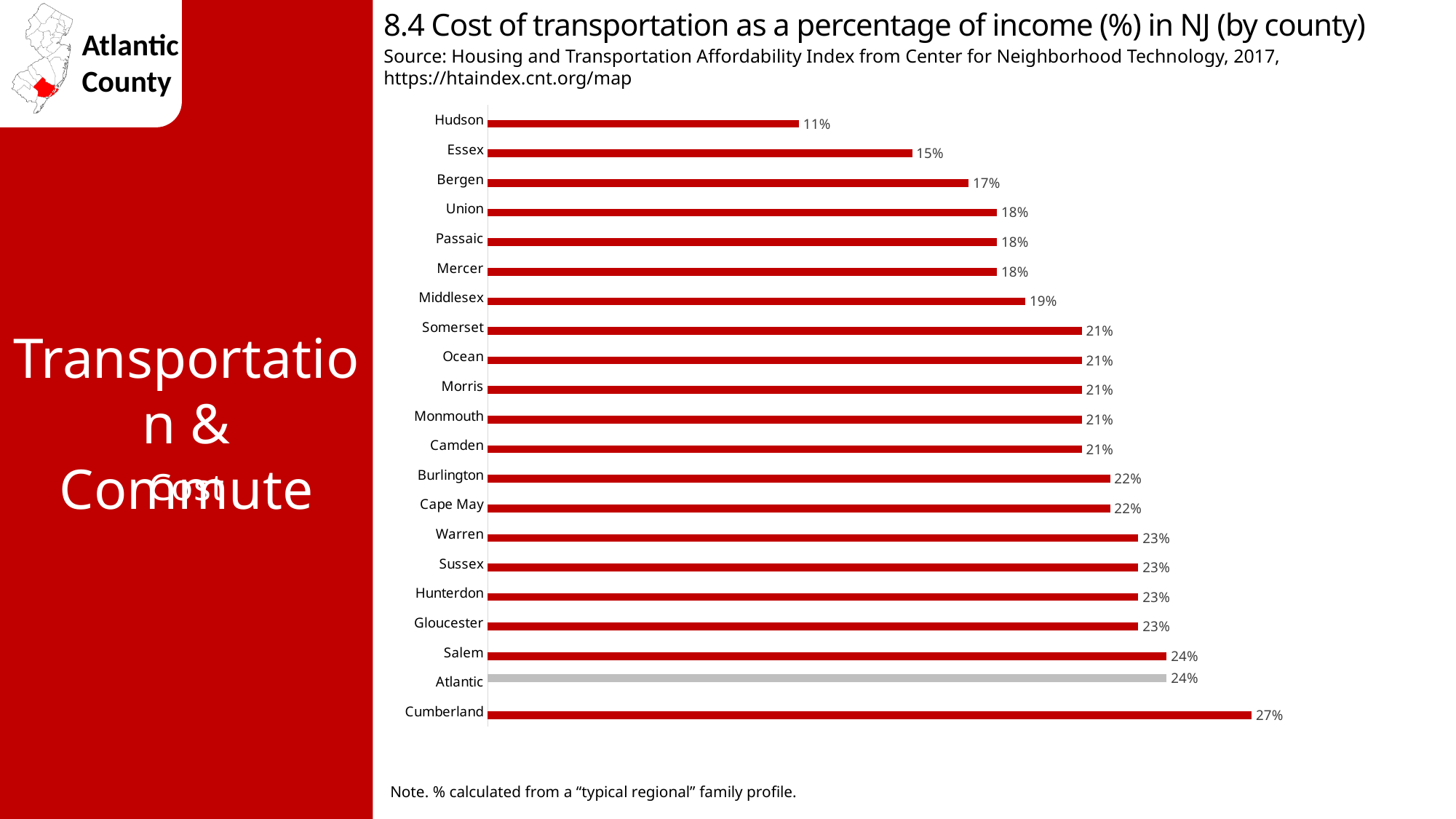
Which has a higher cost of transportation as a percentage of income, Bergen or Warren? Warren How many counties are shown in the chart? 21 What is the cost of transportation as a percentage of income for Middlesex County? 19% What is the difference in percentage points between Cumberland and Hudson? 16 What is the cost of transportation as a percentage of income for Atlantic County? 24% Which county's bar is shown in gray rather than red? Atlantic What is the value for Salem County? 24% What is the cost of transportation as a percentage of income for Hudson County? 11% Which county has the lowest cost of transportation as a percentage of income? Hudson Which county has the highest cost of transportation as a percentage of income? Cumberland What is the difference in percentage points between Atlantic and Essex? 9 What type of chart is used on this slide? Bar chart